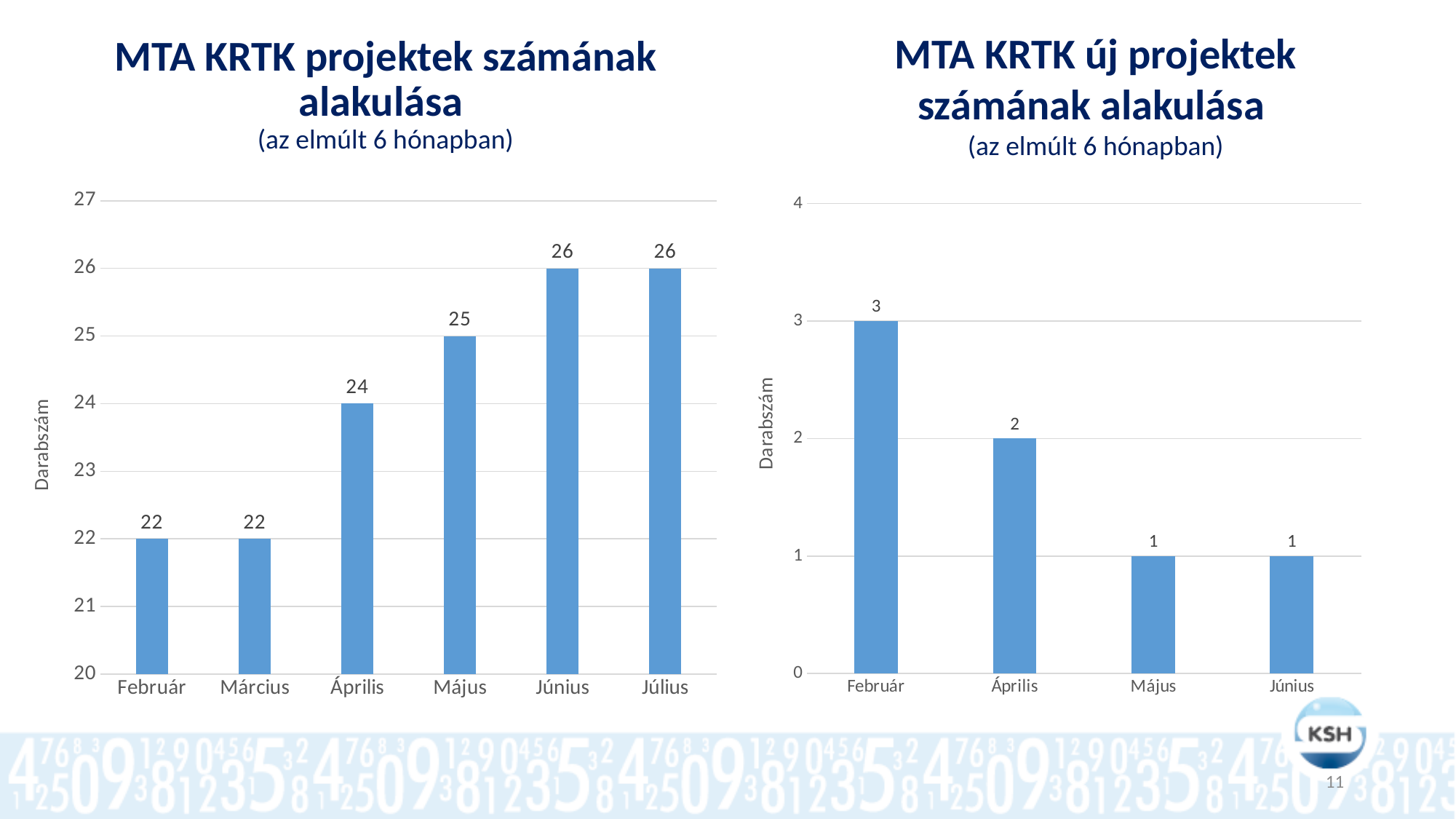
What is the y-axis label of the left chart (MTA KRTK projektek számának alakulása)? Darabszám What kind of chart is the right chart (MTA KRTK új projektek számának alakulása)? Bar chart In the left chart (MTA KRTK projektek számának alakulása), what is the difference between the values for Július and Február? 4 In the right chart (MTA KRTK új projektek számának alakulása), what is the difference between the values for Február and Április? 1 In the right chart (MTA KRTK új projektek számának alakulása), do the values rise or fall from Február to Június? Fall In the left chart (MTA KRTK projektek számának alakulása), which is larger, the value for Május or the value for Március? Május How many months are shown on the x axis of the right chart (MTA KRTK új projektek számának alakulása)? 4 How many months are shown on the x axis of the left chart (MTA KRTK projektek számának alakulása)? 6 In the right chart (MTA KRTK új projektek számának alakulása), what is the value for Február? 3 In the left chart (MTA KRTK projektek számának alakulása), what is the value for Május? 25 In the right chart (MTA KRTK új projektek számának alakulása), which month has the highest value? Február In the left chart (MTA KRTK projektek számának alakulása), what is the value for Április? 24